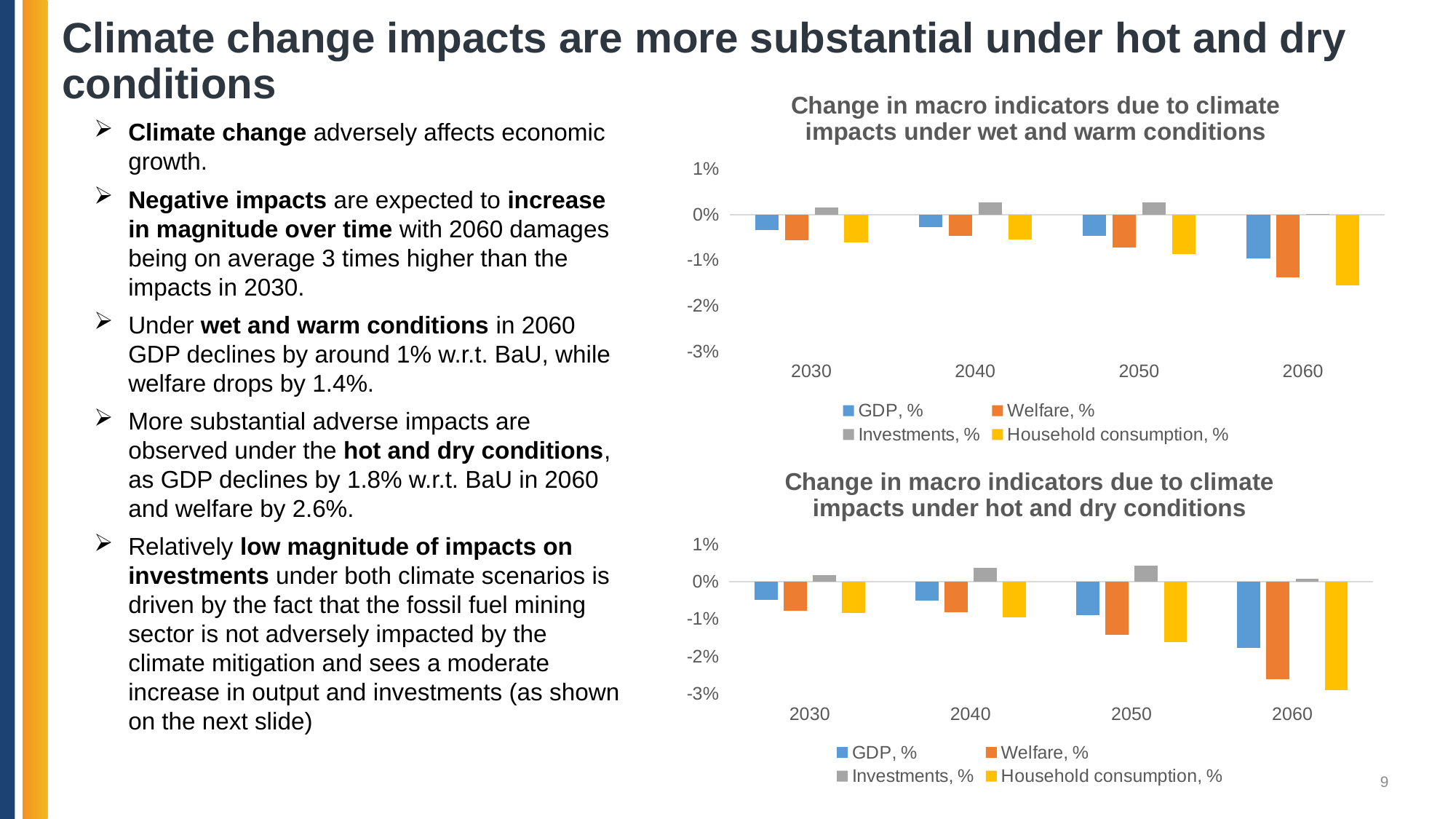
How many years are shown on the x axis of the 'Change in macro indicators due to climate impacts under wet and warm conditions' chart? 4 What kind of chart is the 'Change in macro indicators due to climate impacts under wet and warm conditions' chart? bar chart In the 'Change in macro indicators due to climate impacts under hot and dry conditions' chart, which is larger in 2060, the value for GDP, % or the value for Welfare, %? GDP, % In the 'Change in macro indicators due to climate impacts under hot and dry conditions' chart, which series has the lowest (most negative) value in 2060? Household consumption, % In the 'Change in macro indicators due to climate impacts under wet and warm conditions' chart, which series has the highest value in 2050? Investments, % In the 'Change in macro indicators due to climate impacts under hot and dry conditions' chart, is the value for Welfare, % in 2060 greater or less than -2%? less What colour are the Household consumption, % bars in the 'Change in macro indicators due to climate impacts under hot and dry conditions' chart? yellow In the 'Change in macro indicators due to climate impacts under wet and warm conditions' chart, is the value for Welfare, % in 2060 greater or less than -1%? less How many series does the legend list in the 'Change in macro indicators due to climate impacts under hot and dry conditions' chart? 4 In the 'Change in macro indicators due to climate impacts under hot and dry conditions' chart, is the value for Household consumption, % in 2060 greater or less than -2%? less In the 'Change in macro indicators due to climate impacts under wet and warm conditions' chart, do the GDP, % values rise or fall from 2030 to 2060? fall